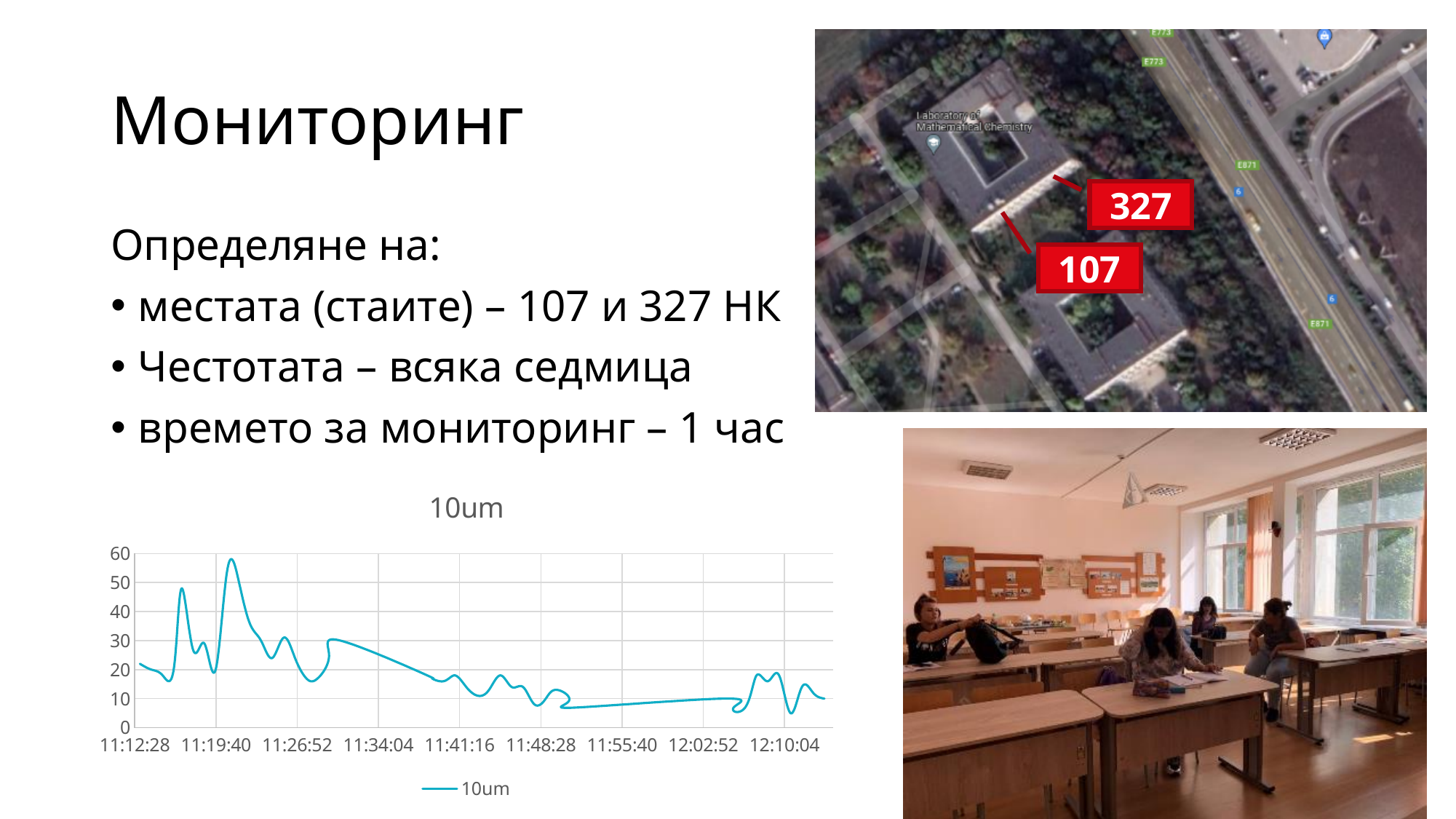
Overall, do the values rise or fall from the start to the end of the x axis? fall How many time labels are shown on the x axis? 9 What is the name of the series in the chart legend? 10um Is the value at 11:12:28 greater or less than 30? less What is the title of the chart? 10um How many series does the chart legend list? 1 Is the value at 11:55:40 greater or less than 20? less What kind of chart is shown on the slide? line chart Is the value at 11:34:04 greater or less than 30? less What is the highest value shown on the y axis? 60